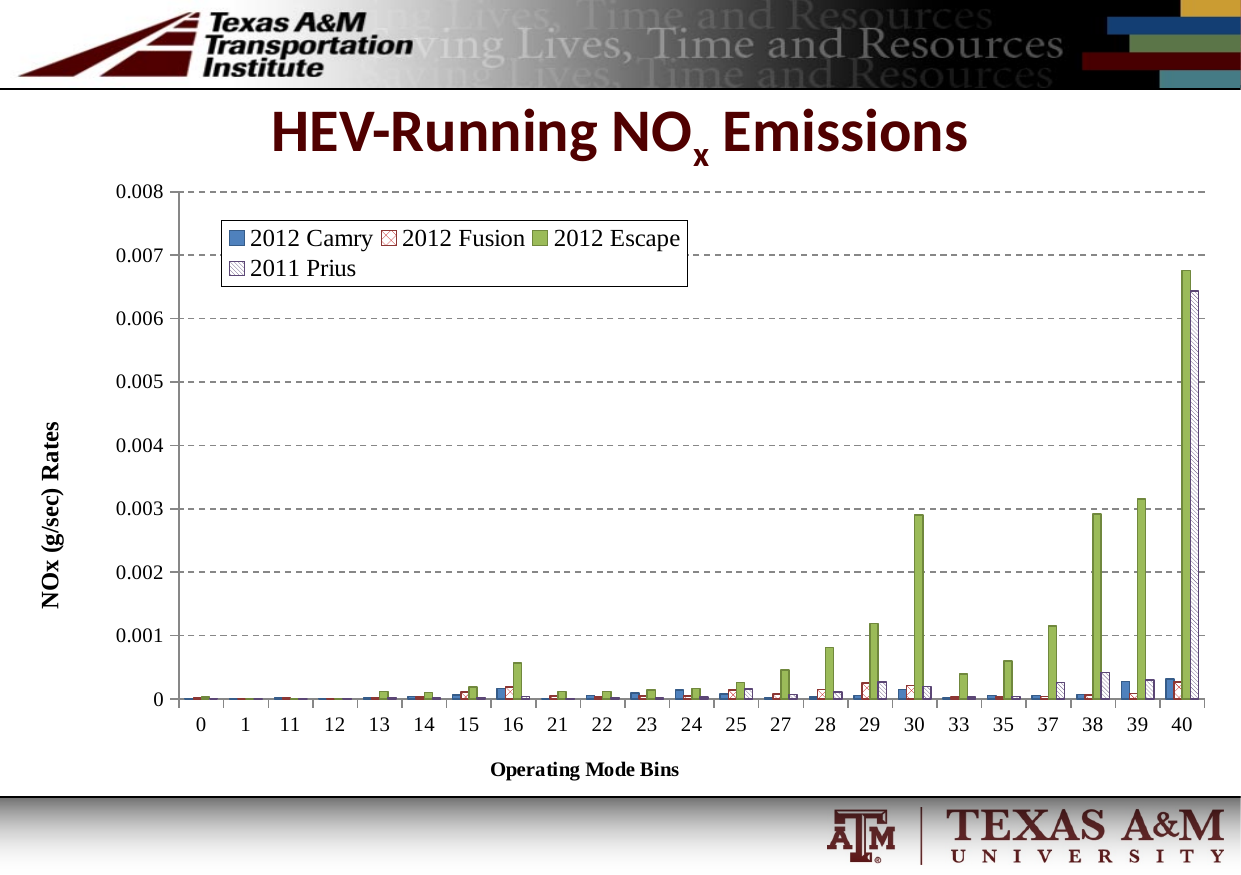
Is the 2012 Escape value at bin 40 greater or less than 0.006? greater Is the 2012 Escape value at bin 29 greater or less than 0.001? greater Is the 2012 Escape value at bin 16 greater or less than 0.001? less At bin 30, which series has the larger value, 2012 Escape or 2012 Camry? 2012 Escape How many series does the legend list? 4 What kind of chart is shown on the slide? bar chart At bin 40, which series has the larger value, 2012 Escape or 2011 Prius? 2012 Escape Which operating mode bin has the highest NOx rate for the 2011 Prius? 40 What is the label of the y axis? NOx (g/sec) Rates How many operating mode bins are shown on the x axis? 23 Which operating mode bin has the highest NOx rate for the 2012 Escape? 40